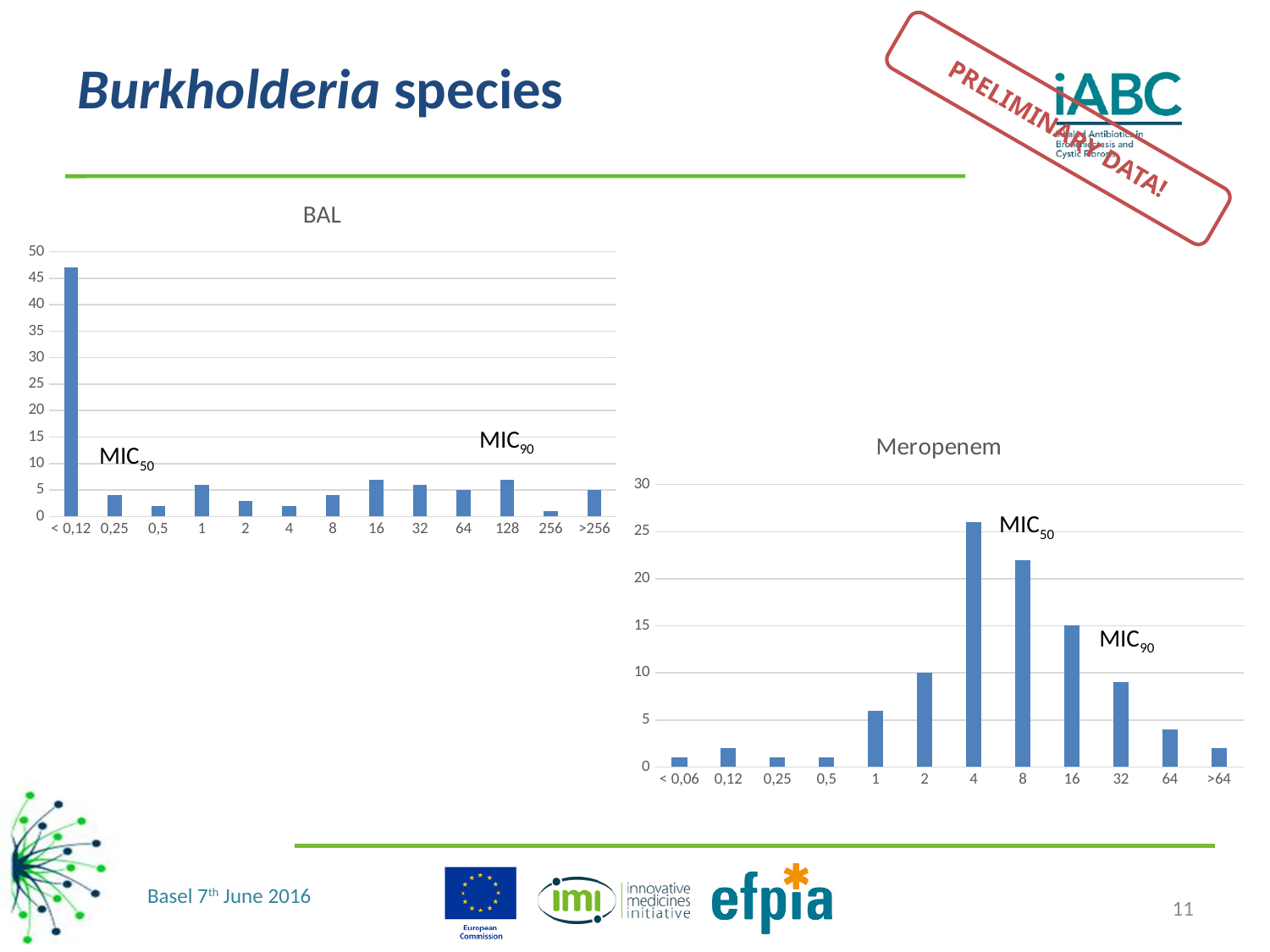
In the BAL chart, which MIC category has the lowest bar? 256 In the BAL chart, is the value for < 0,12 greater or less than 45? greater What kind of chart is the BAL chart? bar chart In the Meropenem chart, which is larger, the value for 8 or the value for 32? 8 How many MIC categories are shown on the x axis of the BAL chart? 13 In the Meropenem chart, is the value for 4 greater or less than 25? greater How many MIC categories are shown on the x axis of the Meropenem chart? 12 In the BAL chart, is the value for 16 greater or less than 5? greater In the BAL chart, which MIC category has the highest bar? < 0,12 In the Meropenem chart, which MIC category has the highest bar? 4 In the Meropenem chart, what is the value for MIC category 16? 15